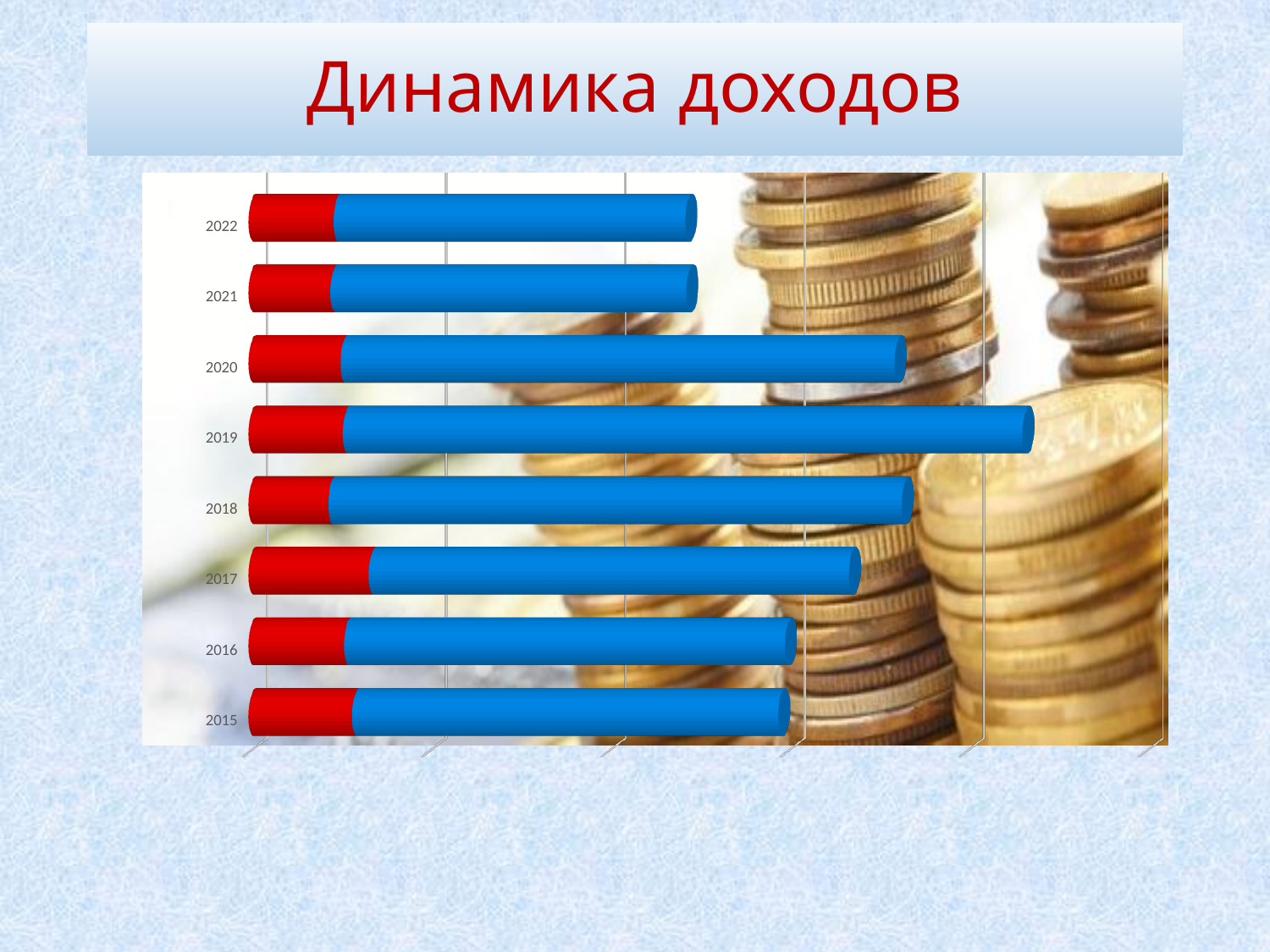
Which is the latest year shown on the chart? 2022 Which is the earliest year shown on the chart? 2015 How many years (categories) are shown on the chart? 8 What kind of chart is shown on the slide? Bar chart Do the total bar lengths rise or fall from 2019 to 2022? Fall Which year has the longest total bar on the chart? 2019 Which year has the longer total bar, 2020 or 2021? 2020 Which year has the longer total bar, 2018 or 2016? 2018 What two colours are used for the segments of each bar? Red and blue What is the title of the slide with the chart? Динамика доходов Do the total bar lengths rise or fall from 2015 to 2019? Rise Which year has the longer total bar, 2019 or 2020? 2019